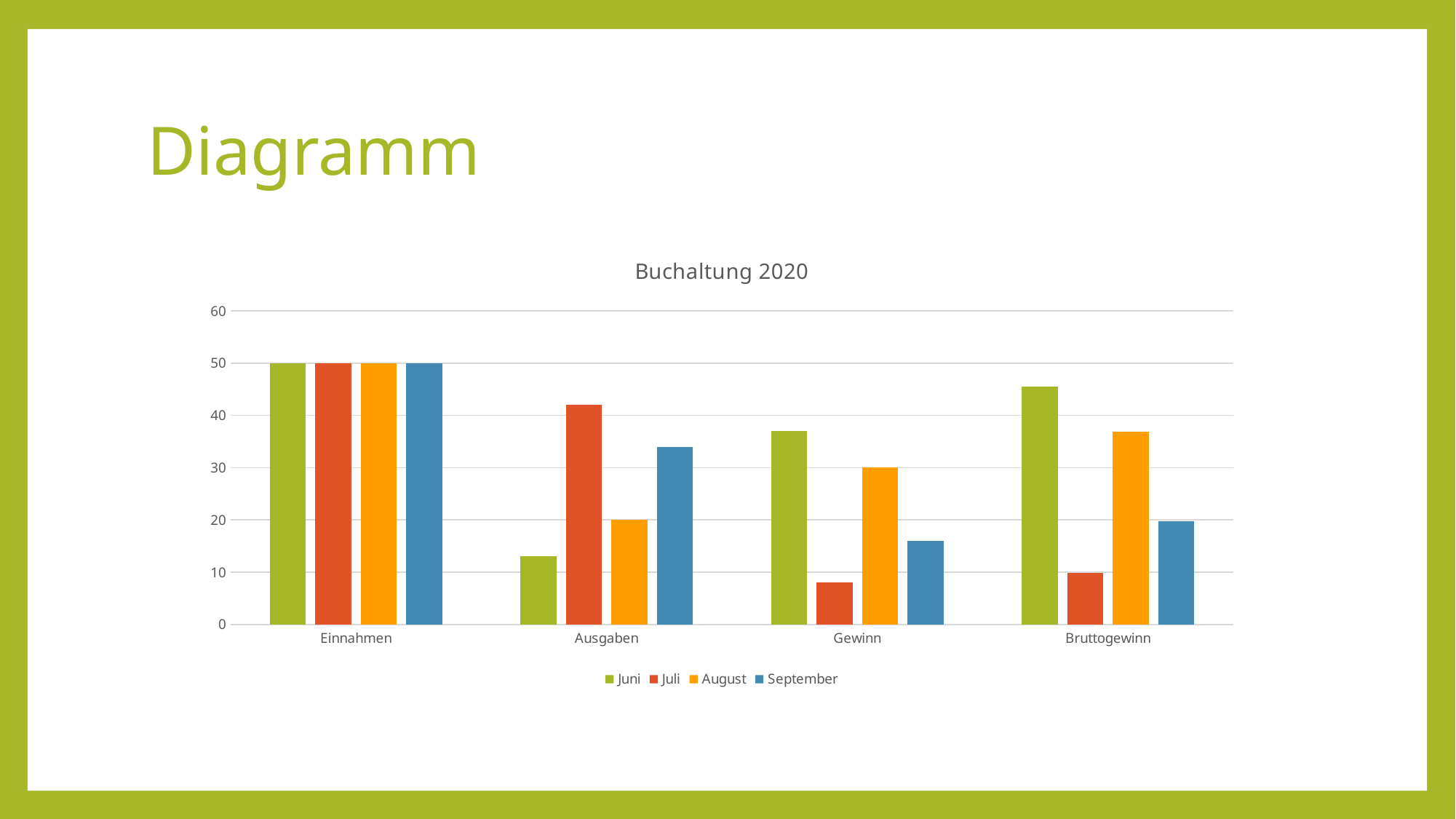
Which series has the lowest value in the Gewinn category? Juli What is the value for Juni in the Einnahmen category? 50 What is the value for August in the Ausgaben category? 20 How many categories are shown on the x axis? 4 How many series does the legend list? 4 What is the title of the chart? Buchaltung 2020 What is the value for August in the Gewinn category? 30 Which series has the highest value in the Ausgaben category? Juli What kind of chart is shown on the slide? bar chart Which is larger in the Gewinn category, Juni or September? Juni Is the value for Juni in the Bruttogewinn category greater or less than 40? greater